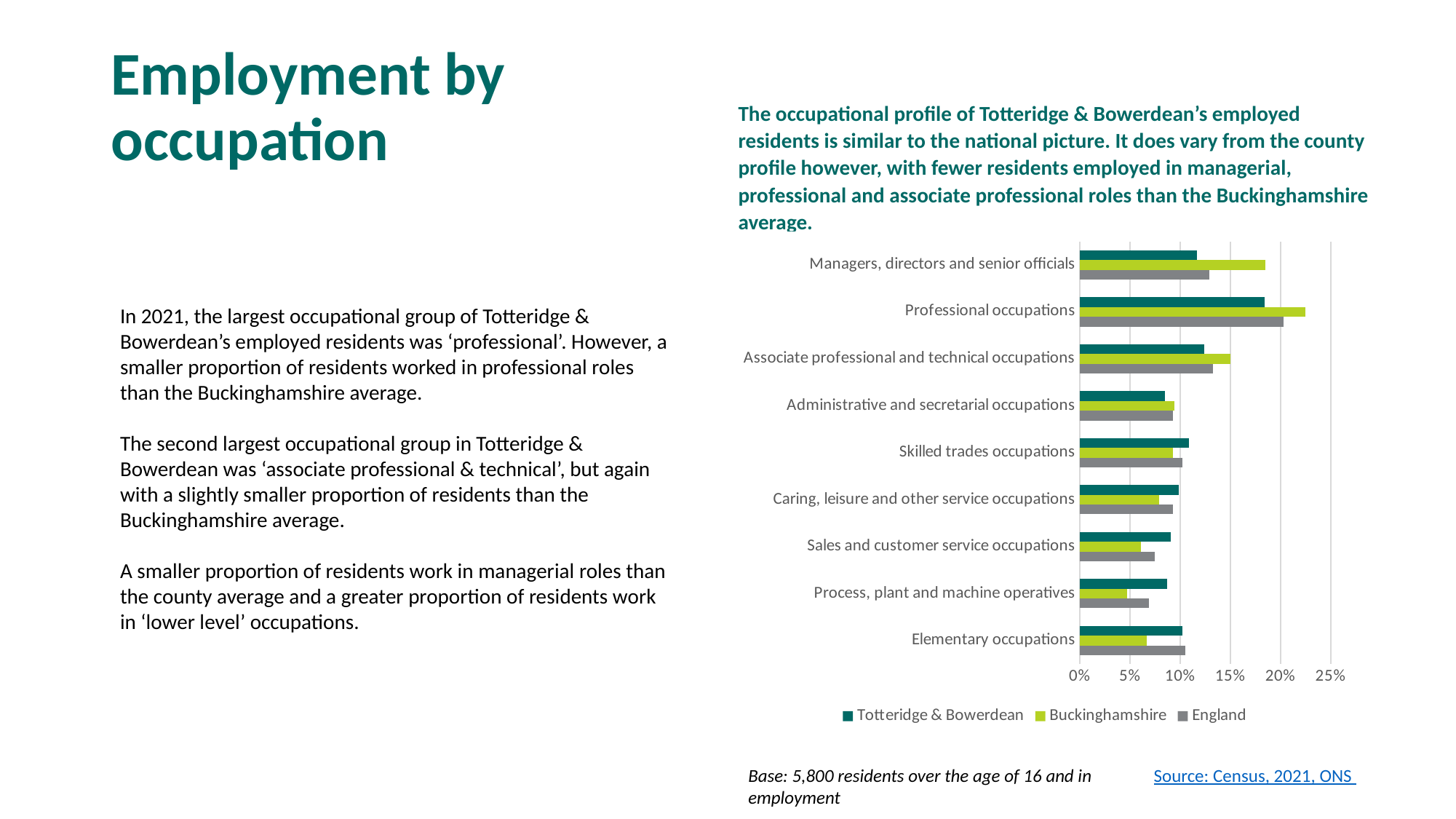
Is the Buckinghamshire value for Sales and customer service occupations greater or less than 10%? less Is the Totteridge & Bowerdean value for Managers, directors and senior officials greater or less than 15%? less How many series does the chart's legend list? 3 Which occupation category has the lowest value for Buckinghamshire? Process, plant and machine operatives For Managers, directors and senior officials, which is larger: the Totteridge & Bowerdean value or the Buckinghamshire value? Buckinghamshire What kind of chart is shown on the slide? bar chart How many occupation categories are plotted on the chart? 9 Is the Buckinghamshire value for Professional occupations greater or less than 20%? greater Which occupation category has the highest value for Buckinghamshire? Professional occupations For Process, plant and machine operatives, which is larger: the Totteridge & Bowerdean value or the Buckinghamshire value? Totteridge & Bowerdean Which occupation category has the highest value for Totteridge & Bowerdean? Professional occupations What colour represents England in the chart's legend? grey